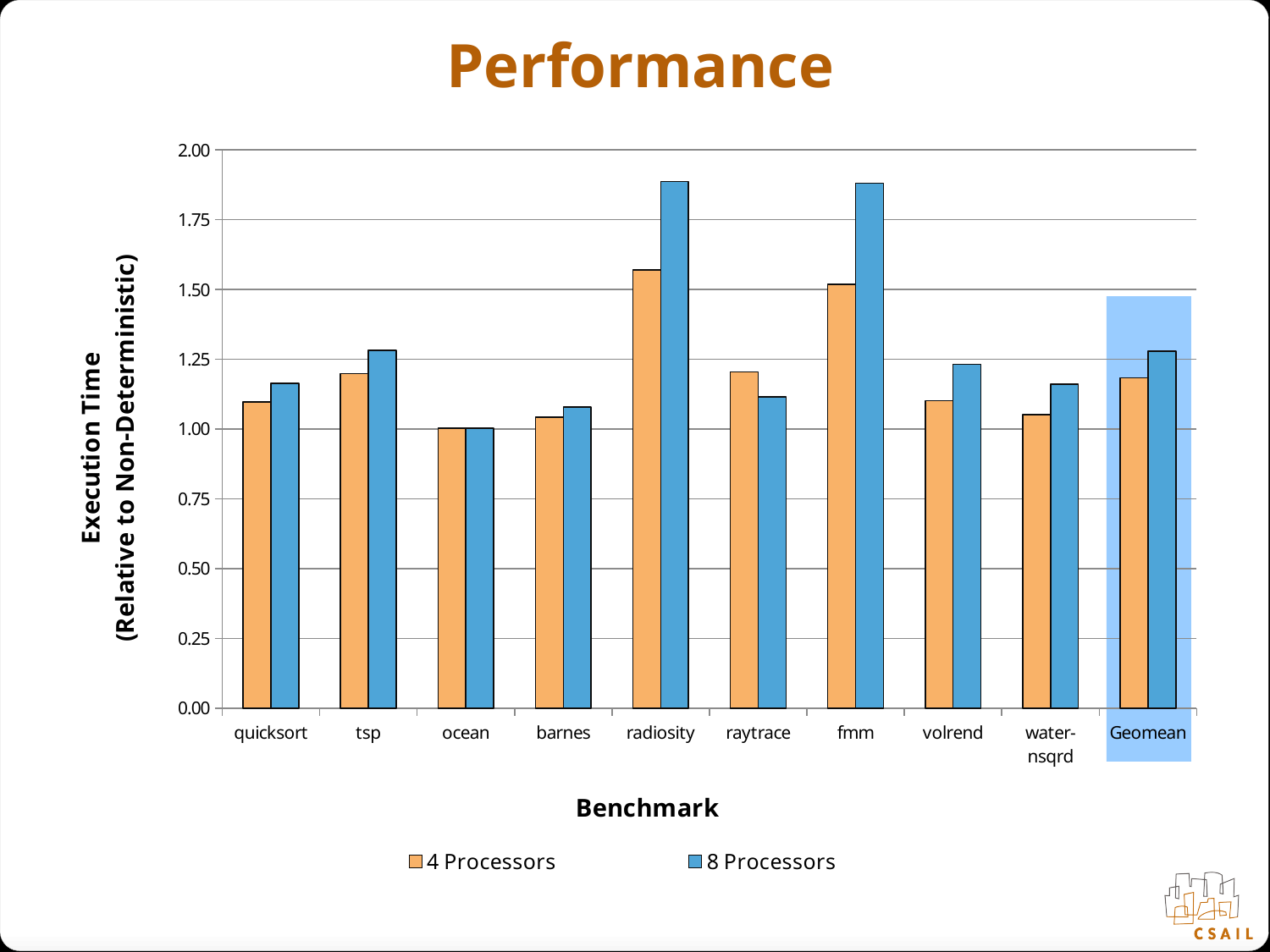
For raytrace, which is larger: the 4 Processors value or the 8 Processors value? 4 Processors Which category on the x axis is highlighted with a blue background? Geomean Is the 8 Processors value for water-nsqrd greater or less than 1.25? less Which benchmark has the lowest execution time for 8 Processors? ocean Is the 4 Processors value for fmm greater or less than 1.25? greater How many series does the legend list? 2 How many benchmark categories are shown on the x axis? 10 For tsp, which is larger: the 4 Processors value or the 8 Processors value? 8 Processors Is the 8 Processors value for radiosity greater or less than 1.75? greater What kind of chart is shown on the slide? bar chart What is the title of the x axis? Benchmark Which benchmark has the lowest execution time for 4 Processors? ocean